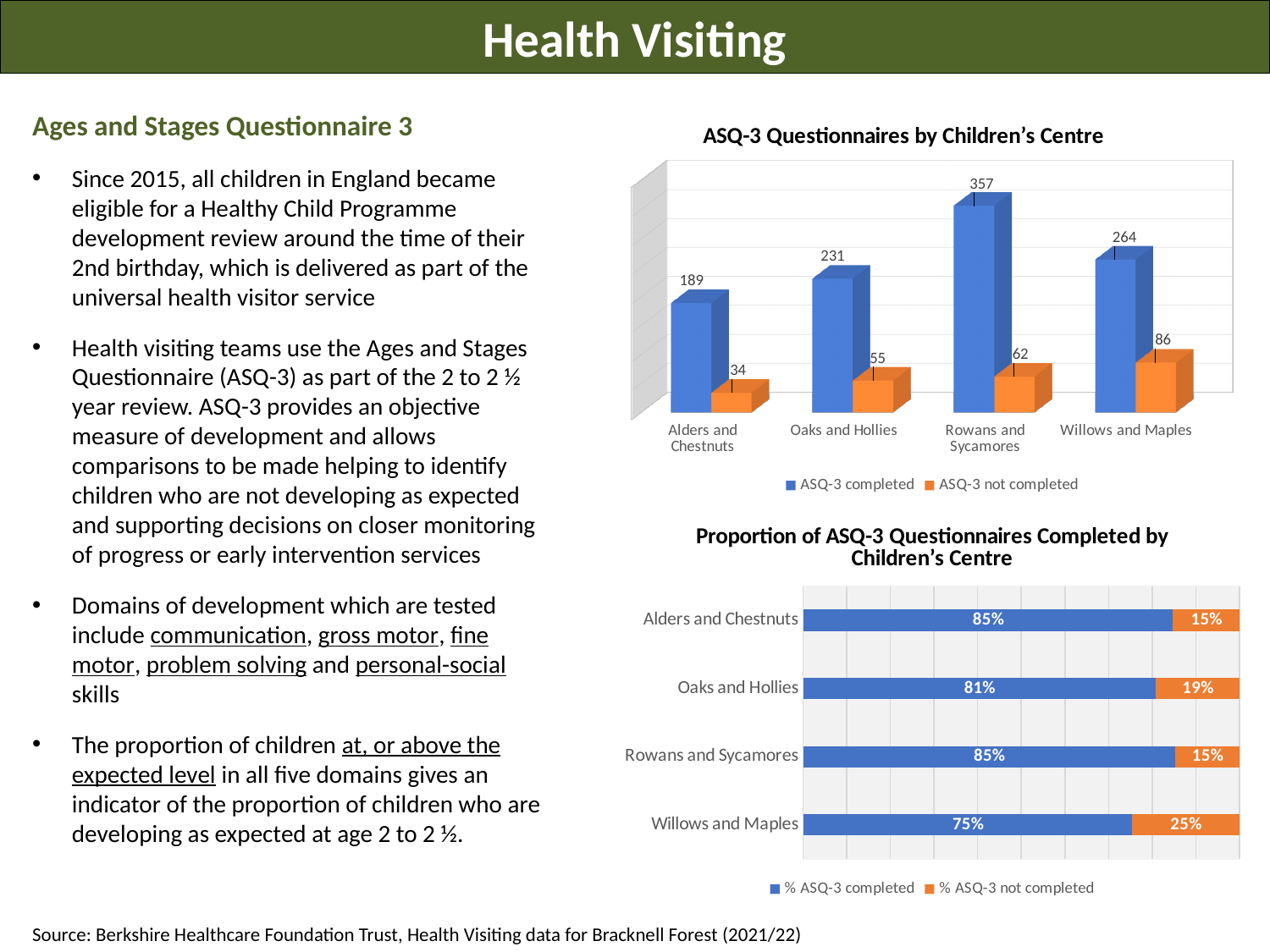
In the 'Proportion of ASQ-3 Questionnaires Completed by Children's Centre' chart, what percentage of ASQ-3 questionnaires were completed at Willows and Maples? 75% In the 'ASQ-3 Questionnaires by Children's Centre' chart, how many ASQ-3 questionnaires were not completed at Alders and Chestnuts? 34 In the 'ASQ-3 Questionnaires by Children's Centre' chart, how many ASQ-3 questionnaires were completed at Rowans and Sycamores? 357 In the 'ASQ-3 Questionnaires by Children's Centre' chart, what is the total number of questionnaires (completed plus not completed) for Oaks and Hollies? 286 What kind of chart is the 'Proportion of ASQ-3 Questionnaires Completed by Children's Centre' chart? Stacked bar chart In the 'ASQ-3 Questionnaires by Children's Centre' chart, what is the difference between ASQ-3 completed at Willows and Maples and at Oaks and Hollies? 33 In the 'Proportion of ASQ-3 Questionnaires Completed by Children's Centre' chart, which is larger: the % ASQ-3 completed at Oaks and Hollies or at Rowans and Sycamores? Rowans and Sycamores In the 'ASQ-3 Questionnaires by Children's Centre' chart, which children's centre has the lowest number of ASQ-3 not completed? Alders and Chestnuts In the 'ASQ-3 Questionnaires by Children's Centre' chart, which children's centre has the highest number of ASQ-3 completed? Rowans and Sycamores In the 'ASQ-3 Questionnaires by Children's Centre' chart, how many series does the legend list? 2 In the 'Proportion of ASQ-3 Questionnaires Completed by Children's Centre' chart, what percentage of ASQ-3 questionnaires were not completed at Oaks and Hollies? 19% In the 'Proportion of ASQ-3 Questionnaires Completed by Children's Centre' chart, which children's centre has the lowest percentage of ASQ-3 completed? Willows and Maples